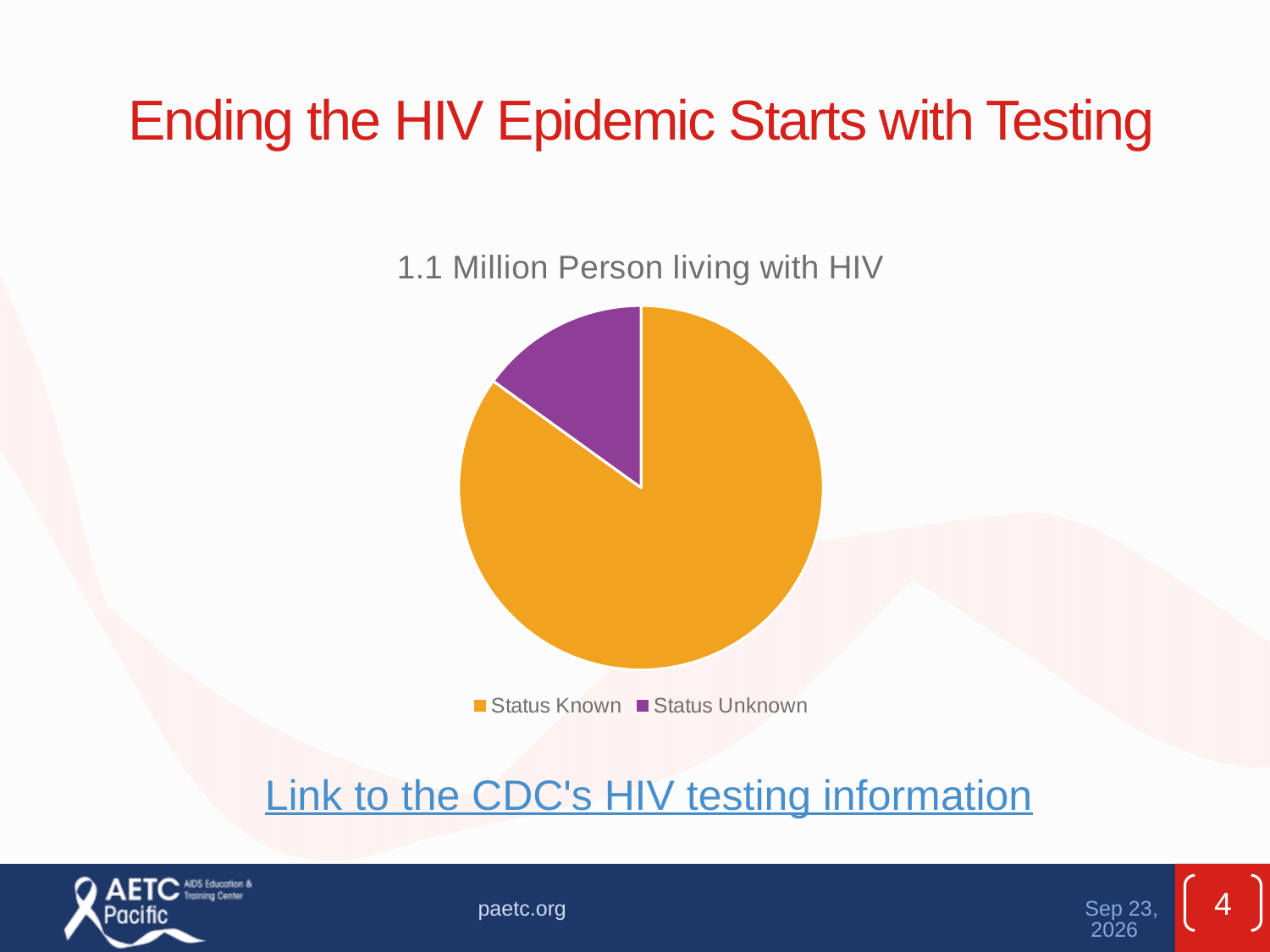
How many slices does the pie chart have? 2 Does the Status Known slice take up more or less than half of the pie? more Which is larger, the Status Known slice or the Status Unknown slice? Status Known What is the title of the chart? 1.1 Million Person living with HIV Which slice of the pie chart is the largest? Status Known What kind of chart is shown on the slide? pie chart What colour is the Status Unknown slice? purple Which slice of the pie chart is the smallest? Status Unknown How many entries does the legend list? 2 Does the Status Unknown slice take up more or less than half of the pie? less